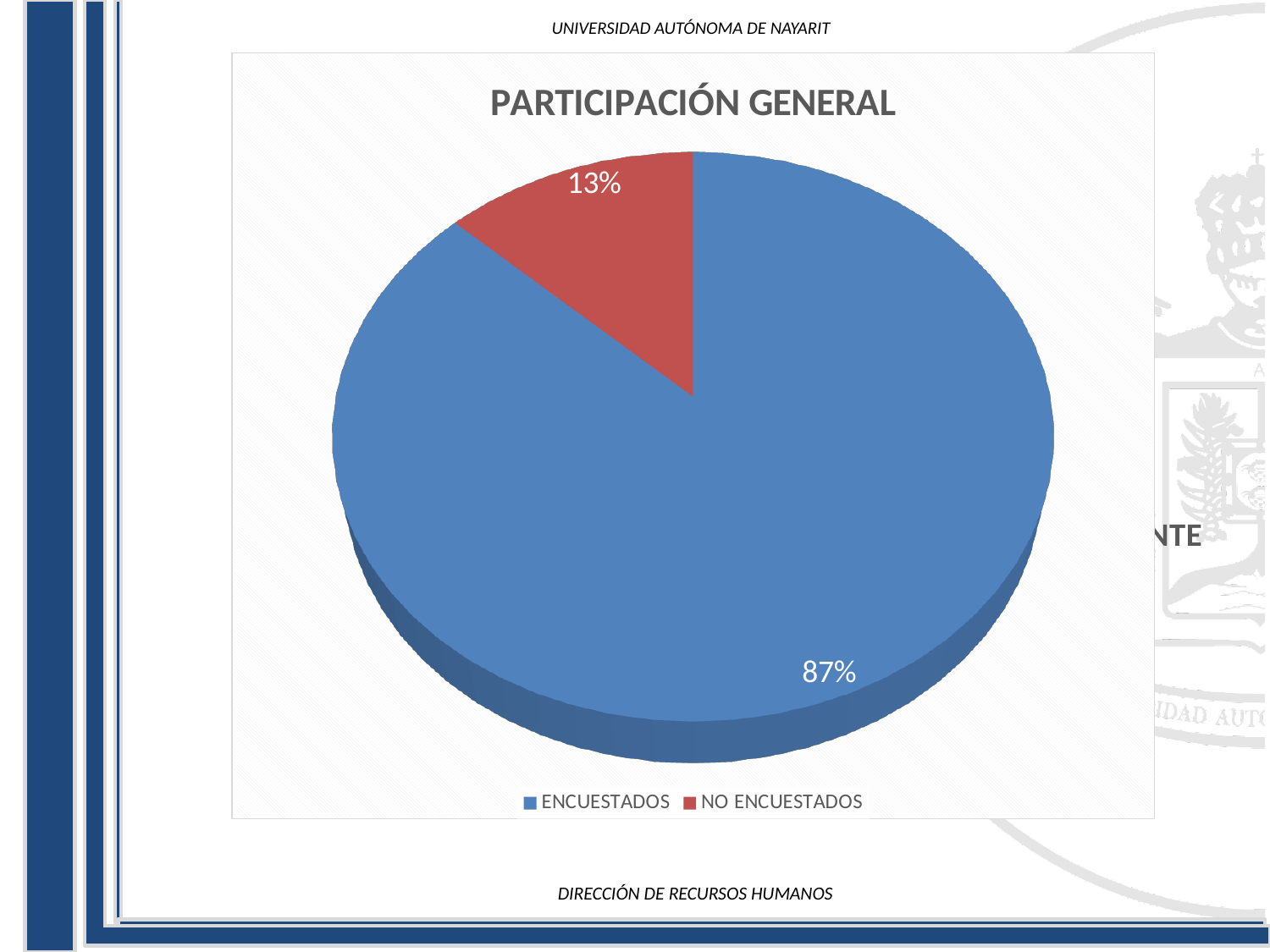
How many categories are shown in the pie chart? 2 Which is larger, the share for ENCUESTADOS or for NO ENCUESTADOS? ENCUESTADOS Which category has the largest slice of the pie? ENCUESTADOS What colour is the slice for NO ENCUESTADOS? Red What share of the pie does ENCUESTADOS represent? 87% What is the title of the chart? PARTICIPACIÓN GENERAL What share of the pie does NO ENCUESTADOS represent? 13% What is the difference in percentage points between ENCUESTADOS and NO ENCUESTADOS? 74 Which category has the smallest slice of the pie? NO ENCUESTADOS What kind of chart is shown on the slide? Pie chart